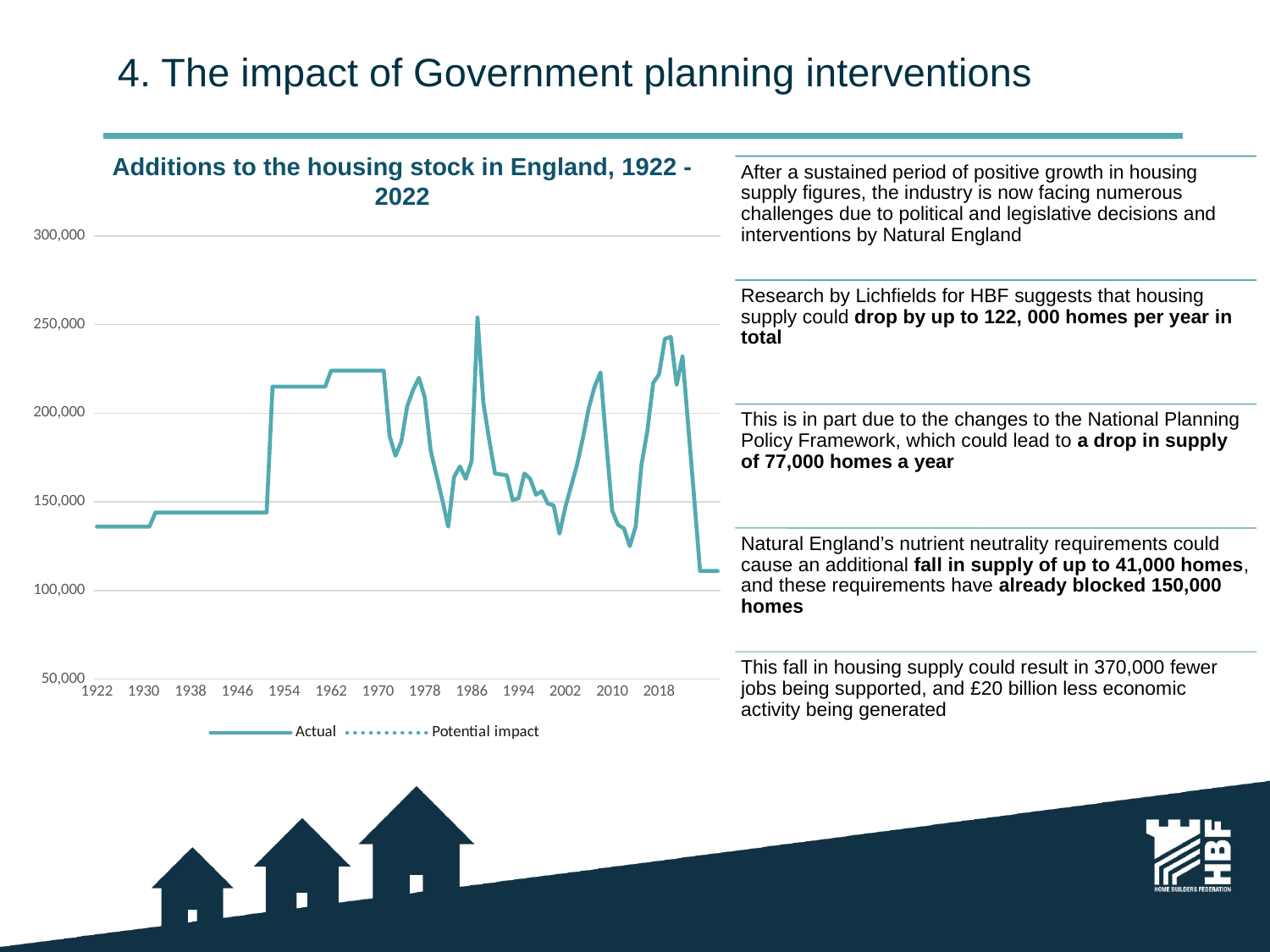
Is the value for 1922 greater or less than 150,000? less Between 1922 and 1962, do the values generally rise or fall? rise Is the highest point on the line greater or less than 200,000? greater Is the value for 1954 greater or less than 200,000? greater What is the title of the chart? Additions to the housing stock in England, 1922 - 2022 What kind of chart is shown on the slide? Line chart How many series does the chart legend list? 2 What are the two series named in the chart legend? Actual and Potential impact